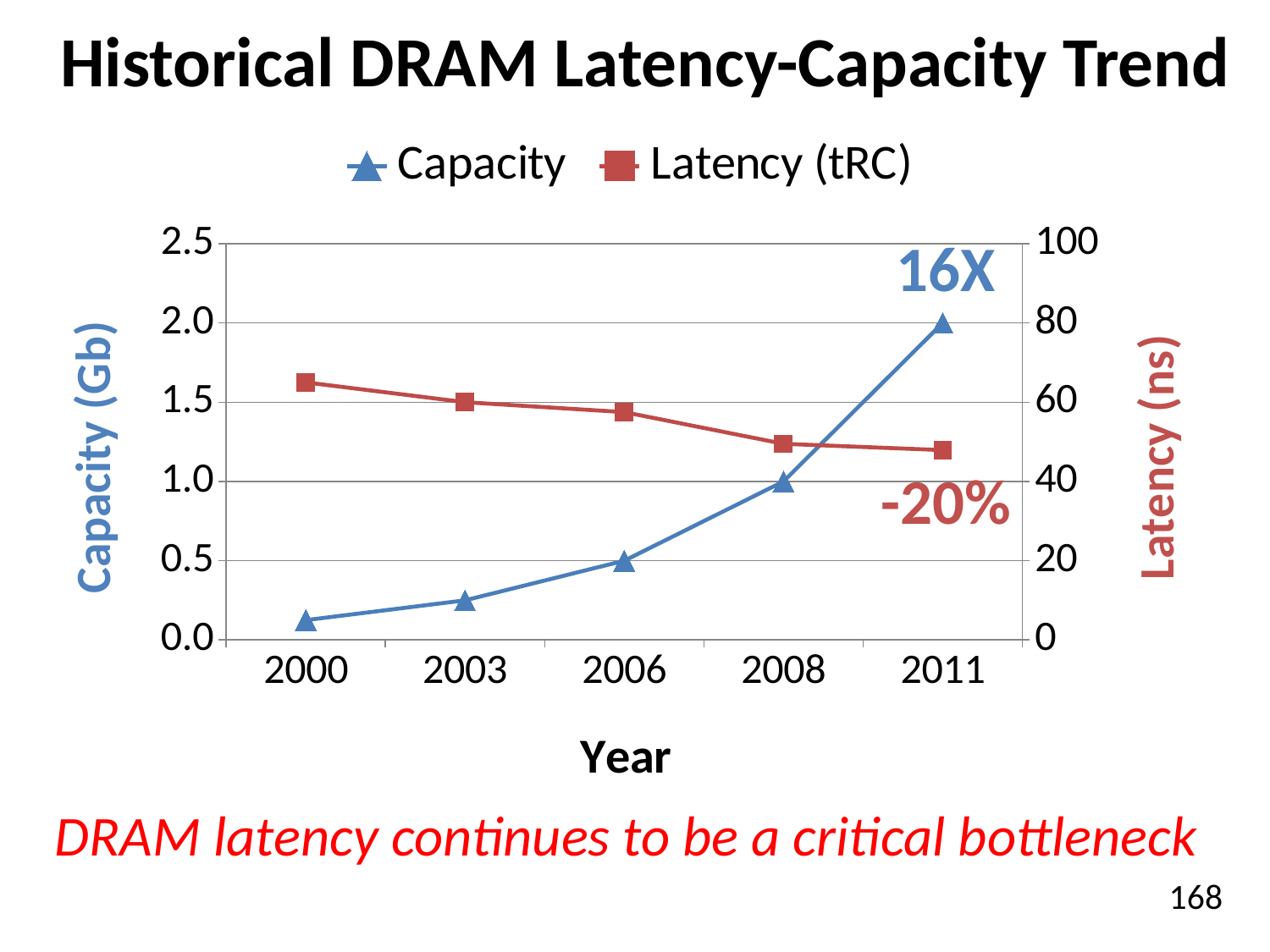
What annotation is printed next to the Capacity line at 2011? 16X Is the Latency (tRC) value for 2000 greater or less than 60? greater Is the Capacity value for 2006 greater or less than 1.0? less Does Latency (tRC) rise or fall from 2000 to 2011? fall Does Capacity rise or fall from 2000 to 2011? rise How many years are plotted along the x axis? 5 What kind of chart is shown on the slide? line chart Which year has the highest Capacity value? 2011 How many series does the legend list? 2 Is the Latency (tRC) value for 2011 greater or less than 60? less Which year has the highest Latency (tRC) value? 2000 Which year has the lowest Capacity value? 2000